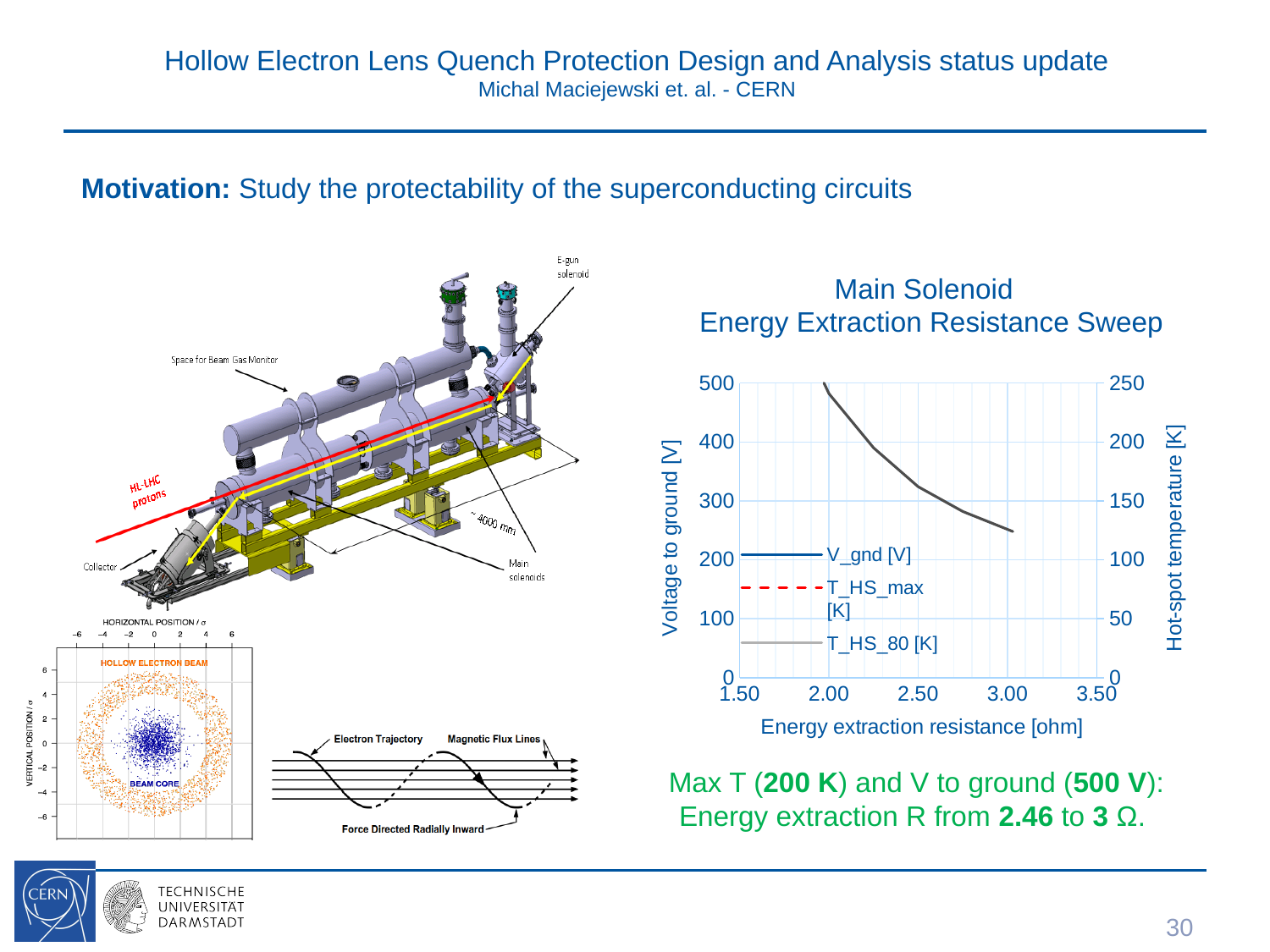
In the Main Solenoid Energy Extraction Resistance Sweep chart, does the plotted curve rise or fall as the energy extraction resistance increases? fall What kind of chart is the Main Solenoid Energy Extraction Resistance Sweep chart? line chart How many series does the legend of the Main Solenoid Energy Extraction Resistance Sweep chart list? 3 What is the label of the x axis of the Main Solenoid Energy Extraction Resistance Sweep chart? Energy extraction resistance [ohm] What is the label of the right-hand y axis of the Main Solenoid Energy Extraction Resistance Sweep chart? Hot-spot temperature [K]